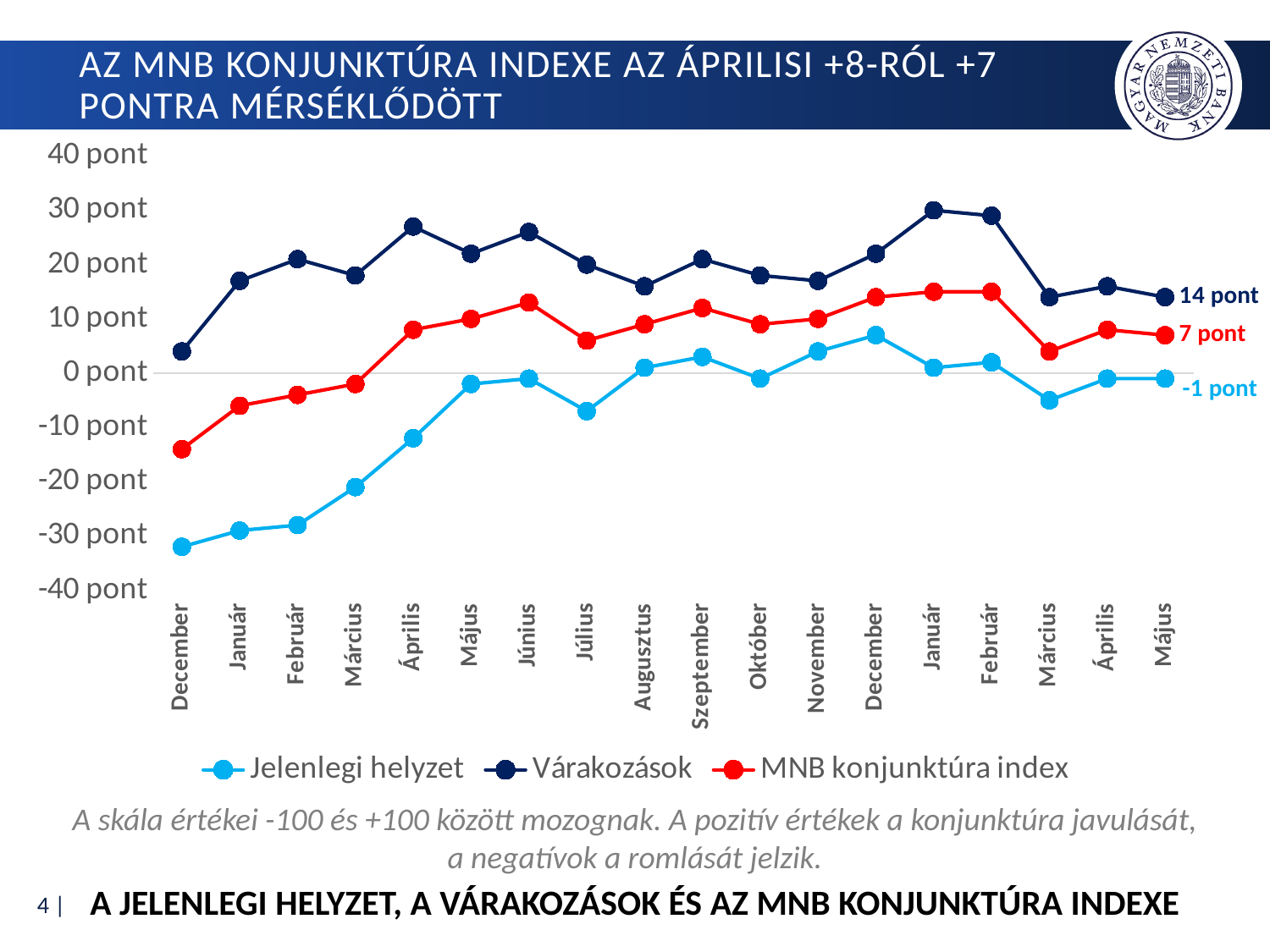
Is the value for Jelenlegi helyzet in the first December greater or less than -30 pont? less At the final Május, what is the difference between the Várakozások value and the MNB konjunktúra index value? 7 pont What is the value of the Jelenlegi helyzet series at the final Május point? -1 pont What colour is the line for the MNB konjunktúra index? Red At the final Május, which series has the highest value? Várakozások Is the value for Várakozások in the second Január greater or less than 20 pont? greater How many months are shown along the x axis? 18 What kind of chart is shown on the slide? Line chart What is the value of the Várakozások series at the final Május point? 14 pont What is the value of the MNB konjunktúra index at the final Május point? 7 pont Does the Jelenlegi helyzet series rise or fall from the first December to the first Május? rise How many series does the legend list? 3